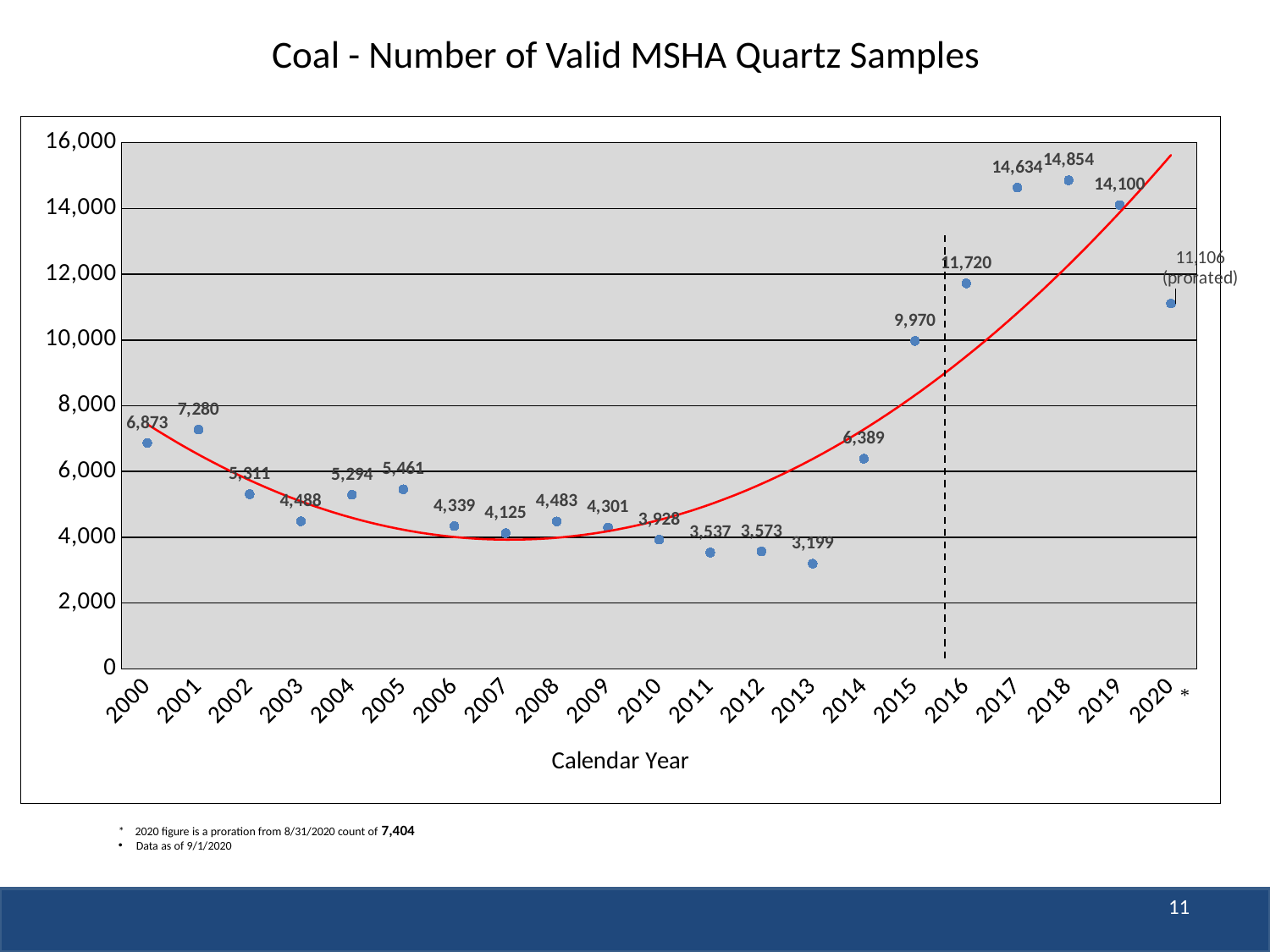
What is the value plotted for 2013? 3,199 Which year has the highest number of valid MSHA quartz samples? 2018 What is the difference between the values for 2018 and 2017? 220 Which year has a larger value, 2001 or 2000? 2001 Which year has the lowest number of valid MSHA quartz samples? 2013 How many years are plotted on the x axis? 21 What is the x-axis title of the chart? Calendar Year What kind of chart is shown on the slide? scatter chart What is the number of valid MSHA quartz samples for 2015? 9,970 What is the difference between the values for 2016 and 2015? 1,750 What is the prorated value shown for 2020? 11,106 Is the value for 2014 greater or less than 6,000? greater